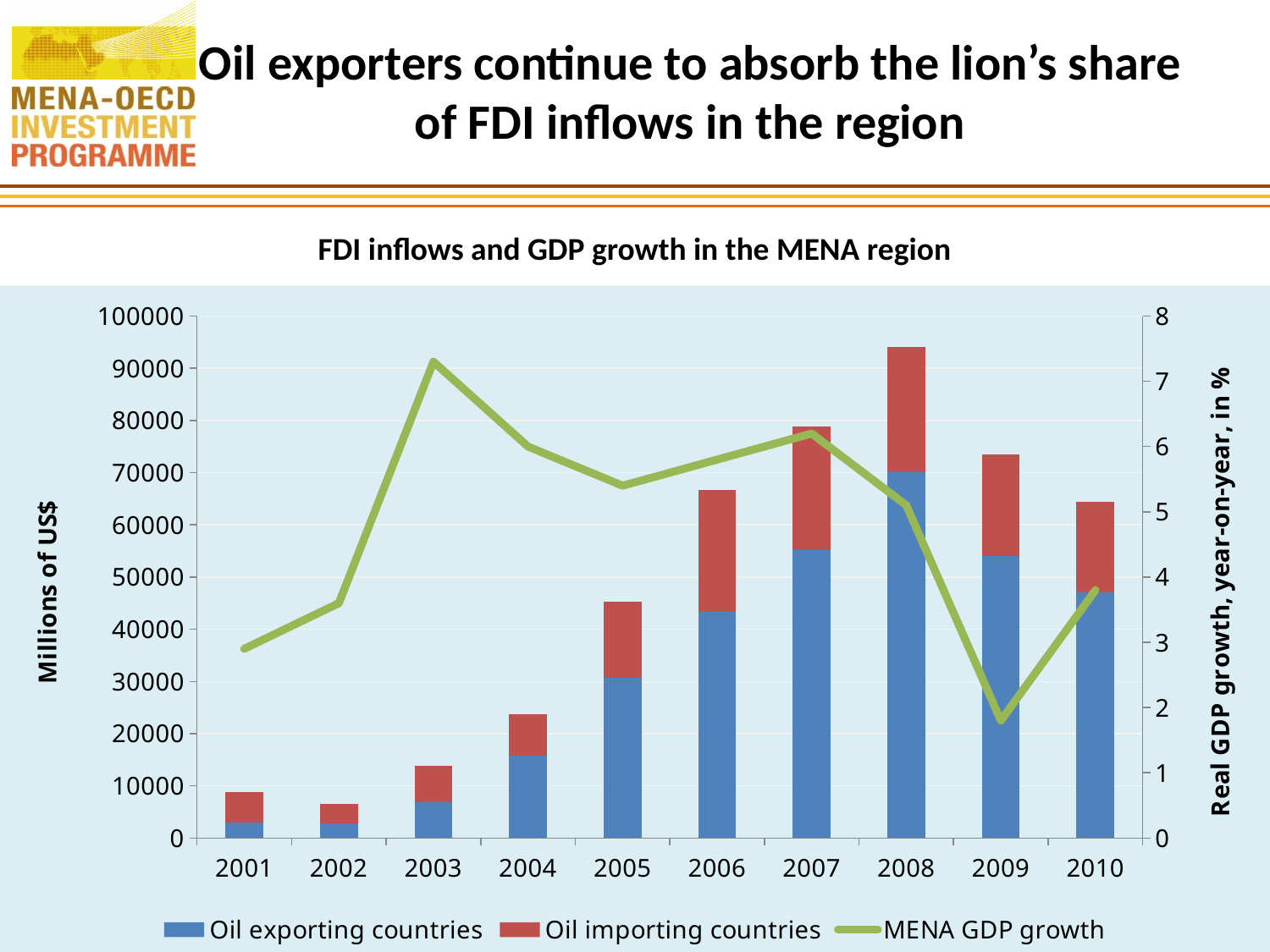
How many years are shown on the x axis? 10 Is the total FDI inflow for 2005 greater or less than 50000? less Which year has the larger total FDI inflow, 2007 or 2009? 2007 How many series does the legend list? 3 What is the label of the left vertical axis? Millions of US$ Do total FDI inflows rise or fall from 2002 to 2008? rise In which year is the total FDI inflow (stacked bar) highest? 2008 In which year is the total FDI inflow (stacked bar) lowest? 2002 What kind of chart is shown on the slide? A combination chart with stacked bars and a line In which year does the MENA GDP growth line reach its lowest point? 2009 In which year does the MENA GDP growth line reach its highest point? 2003 Is the total FDI inflow for 2008 greater or less than 90000? greater